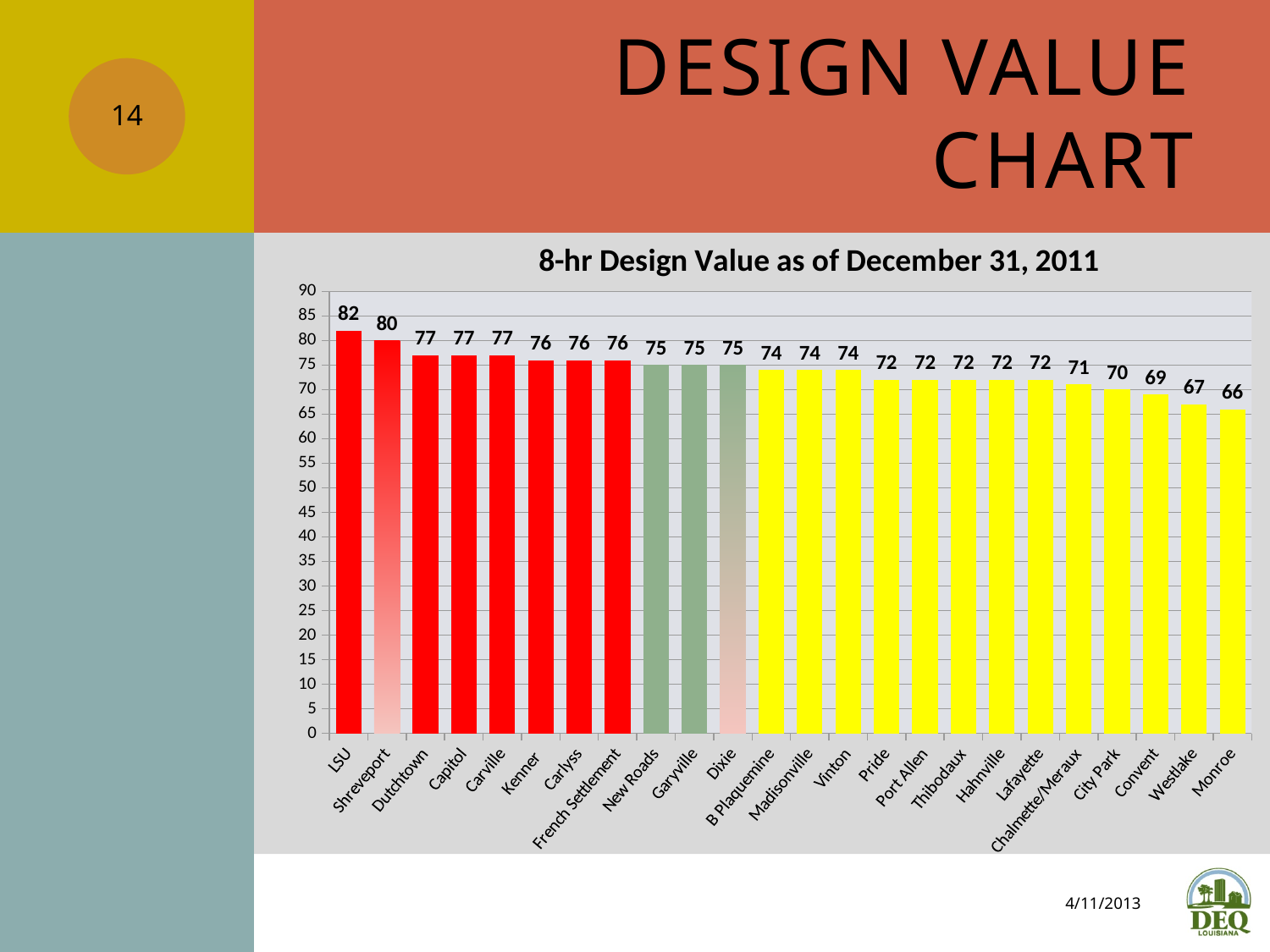
Which site has the highest 8-hr design value? LSU What is the 8-hr design value for Chalmette/Meraux? 71 Is the design value for Garyville greater or less than 70? greater How many sites are shown on the chart? 24 What type of chart is shown on the slide? Bar chart What is the 8-hr design value for Monroe? 66 Which has a higher design value, Shreveport or Convent? Shreveport Which site has the lowest 8-hr design value? Monroe What is the 8-hr design value for Kenner? 76 What is the 8-hr design value for LSU? 82 What is the difference between the design values for Dutchtown and Westlake? 10 What is the difference between the design values for LSU and Shreveport? 2